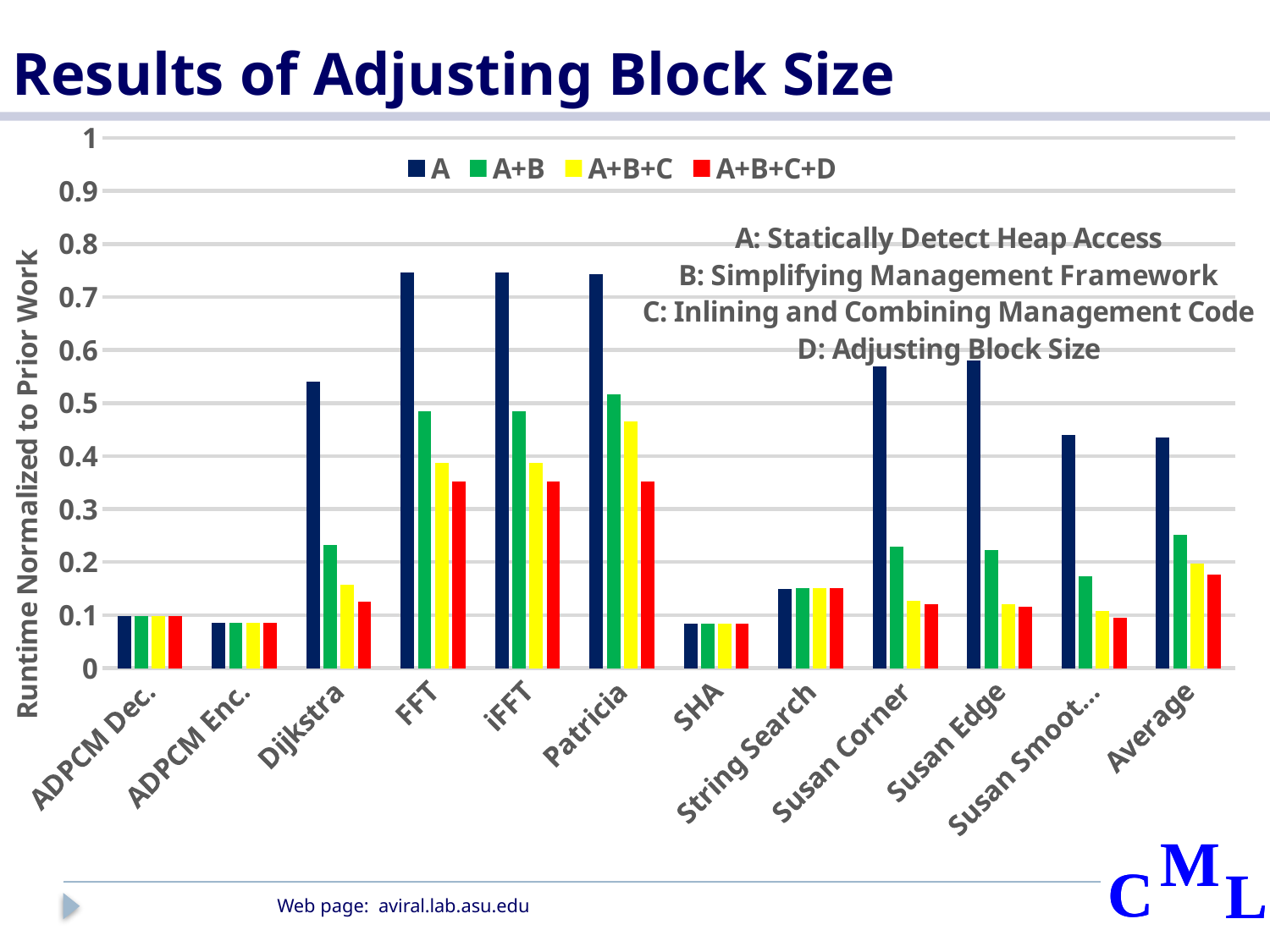
How many series does the legend list? 4 Is the value of the A+B+C+D series for Average greater or less than 0.2? less Is the value of the A series for Dijkstra greater or less than 0.5? greater How many benchmark categories are shown along the x axis? 12 Is the value of the A+B series for Dijkstra greater or less than 0.2? greater What is the title of the y axis? Runtime Normalized to Prior Work Which is larger: the A+B series value for Dijkstra or the A+B series value for Susan Smoot...? Dijkstra What kind of chart is shown on the slide? bar chart According to the annotation on the chart, what does D stand for? Adjusting Block Size Which is larger: the A series value for FFT or the A series value for Susan Edge? FFT